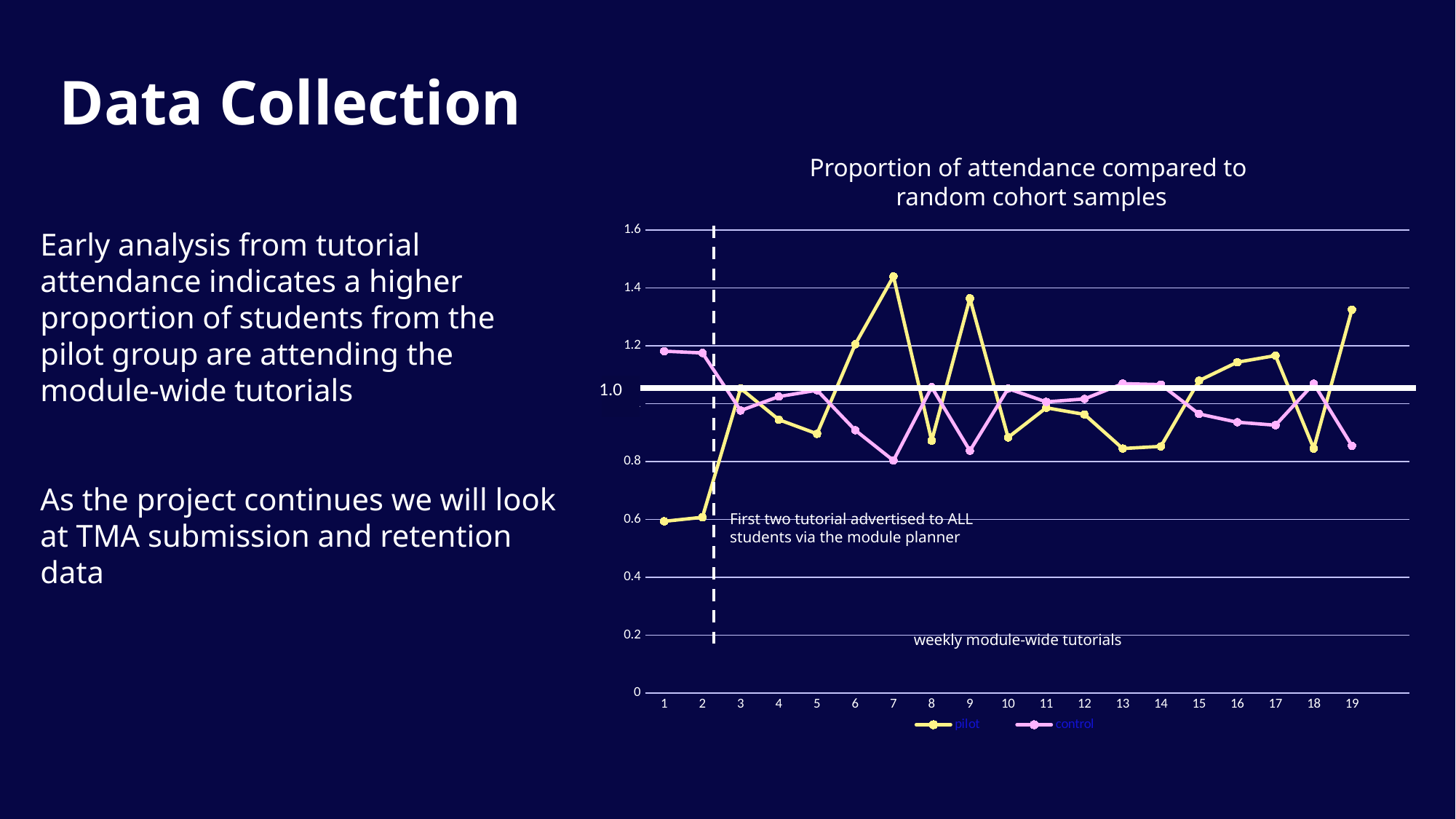
At point 1, which series has the higher value, pilot or control? control Is the control value at point 7 greater or less than 1.0? less Is the pilot value at point 1 greater or less than 0.8? less How many series does the chart legend list? 2 Which series is drawn in yellow? pilot At which x-axis point does the pilot series have its lowest value? 1 Is the pilot value at point 7 greater or less than 1.2? greater What is the title of the chart? Proportion of attendance compared to random cohort samples At which x-axis point does the pilot series reach its highest value? 7 How many points are plotted along the x axis for each series? 19 Does the pilot series rise or fall from point 1 to point 3? rise What kind of chart is shown on the slide? line chart